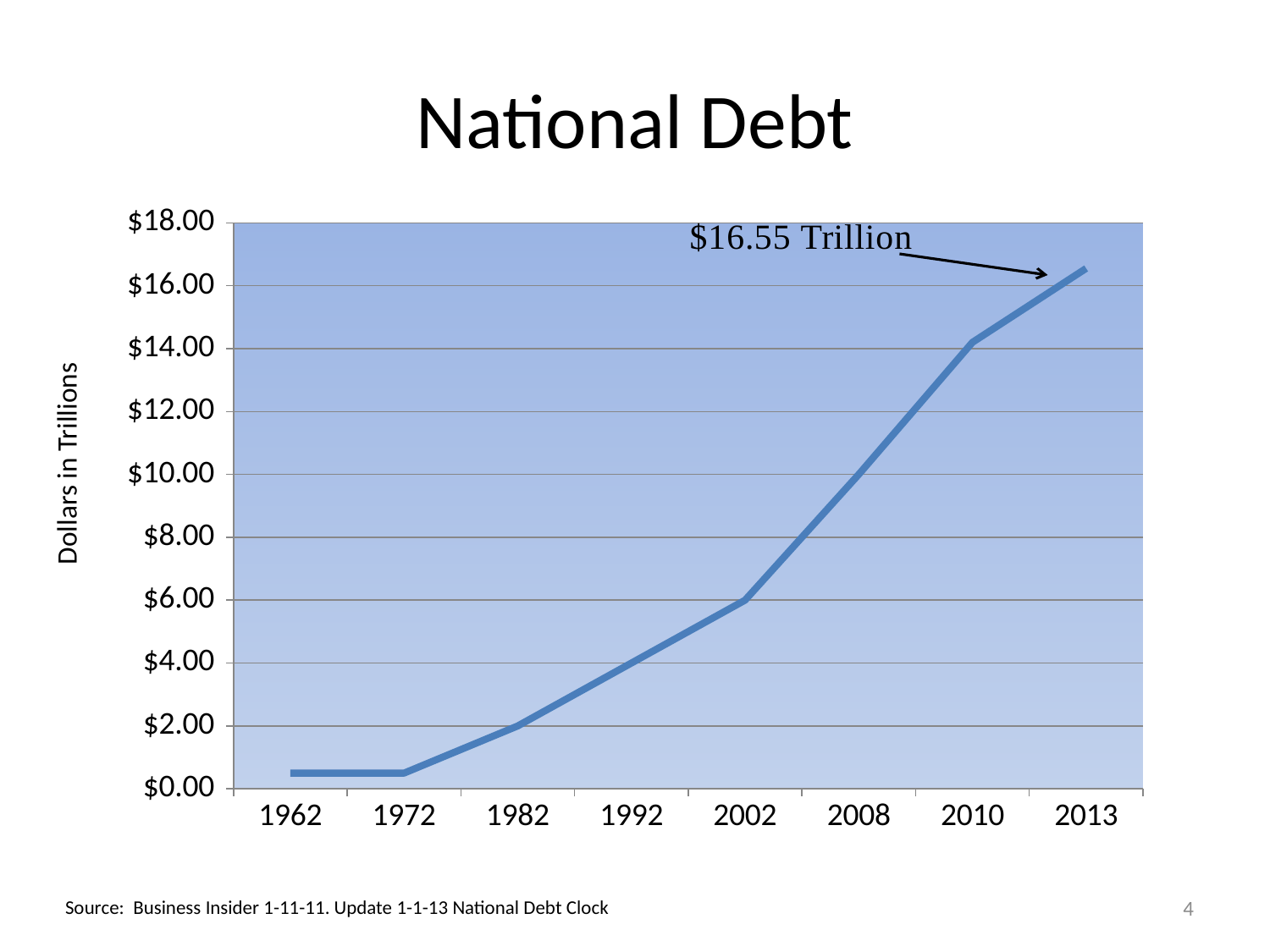
How many years are plotted on the x axis? 8 Is the value for 1992 greater or less than $6.00? less Which year has the highest national debt on the chart? 2013 Which year has the larger national debt, 2002 or 2010? 2010 Is the value for 1962 greater or less than $2.00? less Is the value for 2008 greater or less than $8.00? greater What is the national debt value labeled for 2013? $16.55 Trillion Does the national debt rise or fall from 1962 to 2013? rise What is the label on the vertical axis? Dollars in Trillions What is the title of the chart? National Debt What kind of chart is shown on the slide? line chart